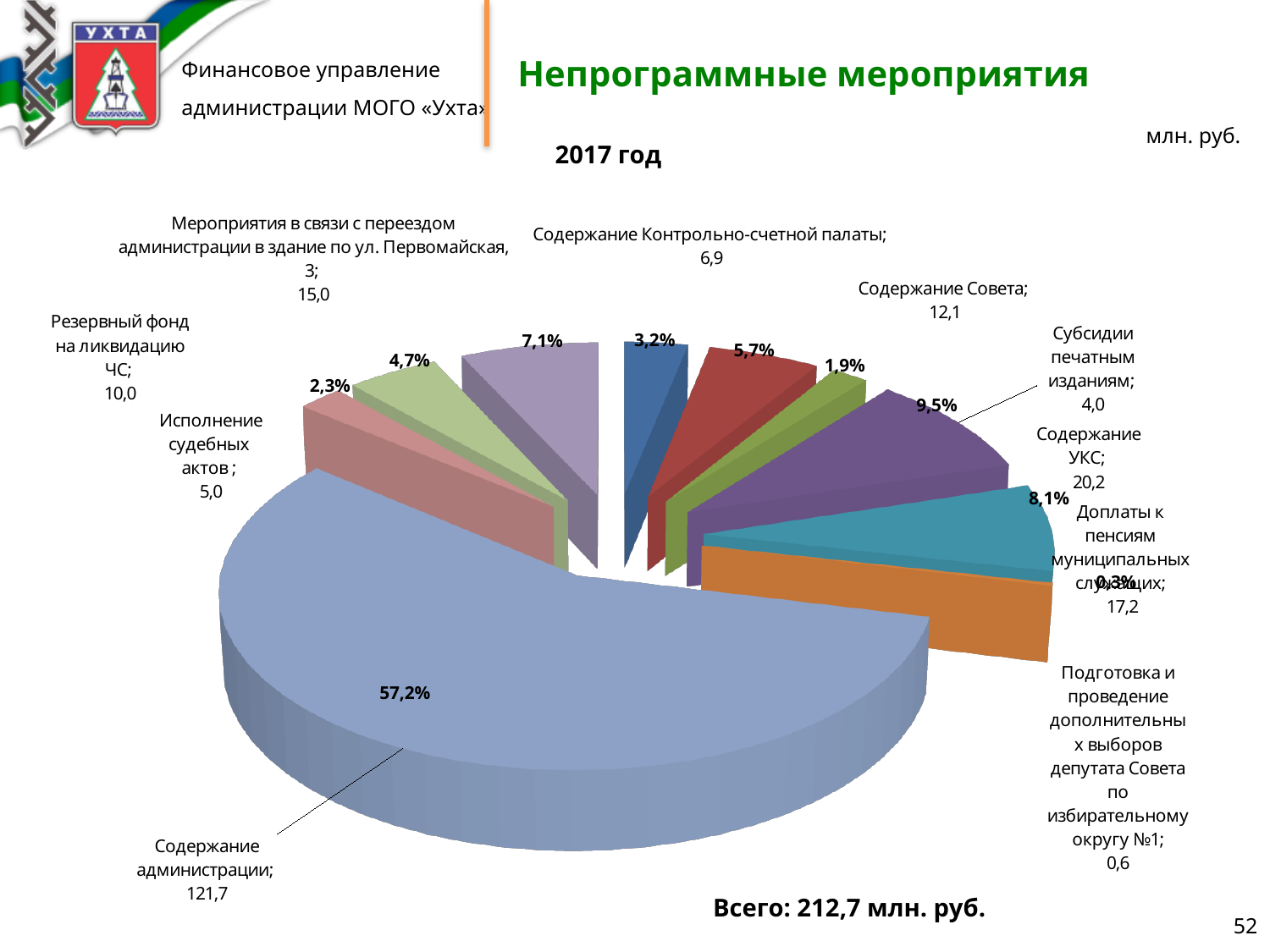
Which category has the largest slice of the pie? Содержание администрации What share of the pie does «Содержание УКС» represent? 9,5% How many categories (slices) does the pie chart show? 10 What type of chart is shown on the slide? pie chart What is the value for «Содержание УКС»? 20,2 What is the value for «Доплаты к пенсиям муниципальных служащих»? 17,2 What share of the pie does «Содержание администрации» represent? 57,2% Which category has the smallest slice of the pie? Подготовка и проведение дополнительных выборов депутата Совета по избирательному округу №1 Which is larger: the value for «Исполнение судебных актов» or «Субсидии печатным изданиям»? Исполнение судебных актов What is the difference between the values for «Содержание Совета» and «Резервный фонд на ликвидацию ЧС»? 2,1 What is the value for «Содержание Контрольно-счетной палаты»? 6,9 What is the value for «Содержание администрации»? 121,7